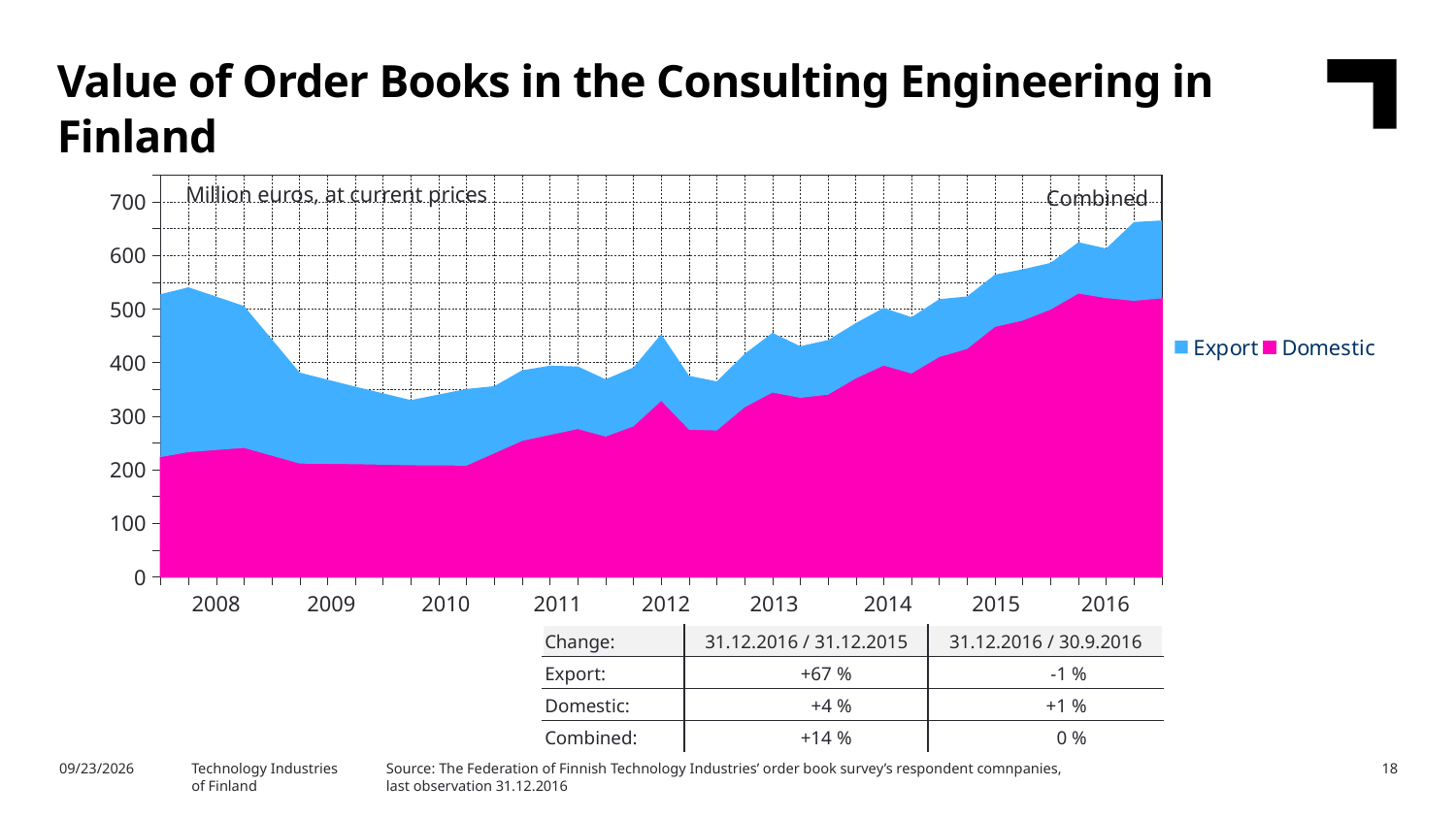
In which year does the combined value reach its highest point? 2016 What unit is stated at the top of the chart? Million euros, at current prices Is the Domestic value at the start of 2008 greater or less than 300? less How many series does the legend list? 2 What are the two series named in the legend? Export and Domestic Is the combined value during 2010 greater or less than 400? less At the end of 2016, which is larger, the Domestic value or the Export value? Domestic According to the table below the chart, what is the Export change for 31.12.2016 / 31.12.2015? +67 % How many years are labelled on the x axis? 9 Does the Domestic value rise or fall from 2012 to 2016? rise Is the combined value at the end of 2016 greater or less than 600? greater What kind of chart is shown on the slide? Area chart